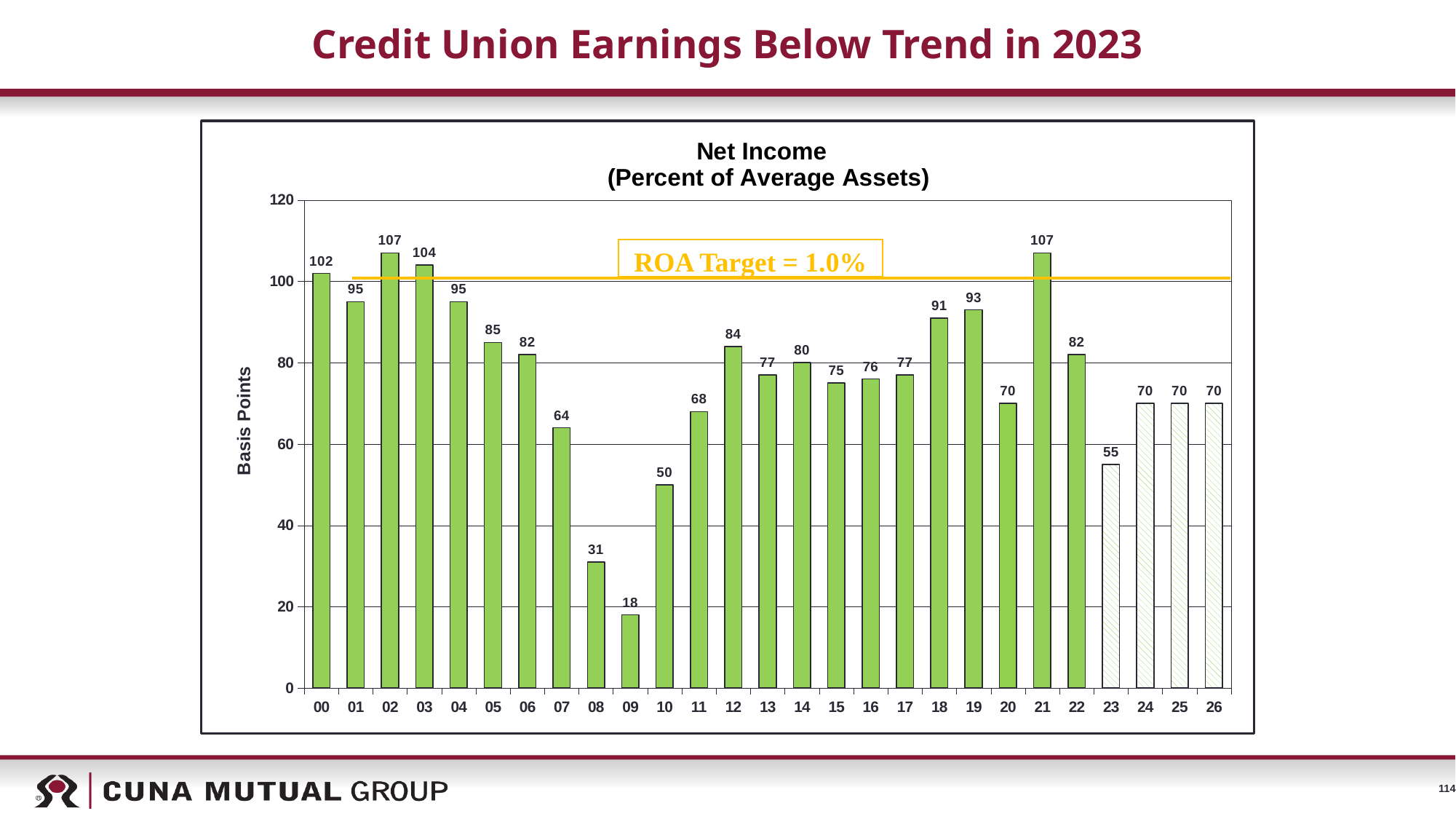
What is the y-axis label of the chart? Basis Points What is the net income value for 12? 84 What is the difference between the values for 00 and 23? 47 What is the net income value for 09? 18 Which year has the lowest net income value? 09 What is the difference between the values for 21 and 22? 25 What ROA target is shown by the horizontal line on the chart? 1.0% What kind of chart is this? bar chart What is the net income value for 23? 55 Which is larger, the value for 18 or the value for 19? 19 How many years are shown on the x axis? 27 Do the values rise or fall from 06 to 09? fall